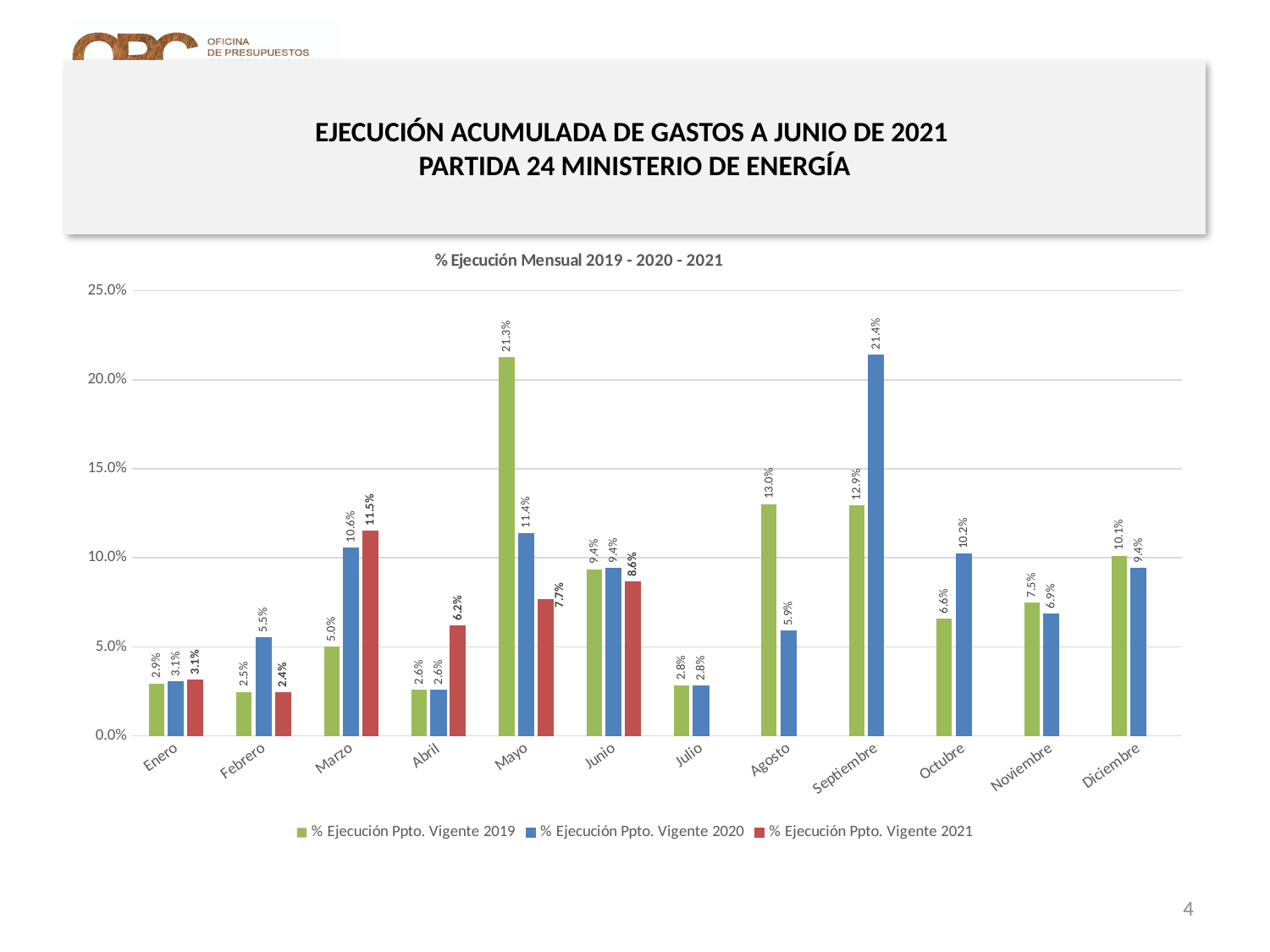
What is the value for % Ejecución Ppto. Vigente 2020 in Octubre? 10.2% Which month has the highest value for % Ejecución Ppto. Vigente 2020? Septiembre Which is larger in Abril: the 2021 value or the 2019 value? 2021 value What is the value for % Ejecución Ppto. Vigente 2019 in Mayo? 21.3% How many series does the legend list? 3 What is the title of the chart? % Ejecución Mensual 2019 - 2020 - 2021 What is the value for % Ejecución Ppto. Vigente 2021 in Marzo? 11.5% Which month has the lowest value for % Ejecución Ppto. Vigente 2021? Febrero Is the value for % Ejecución Ppto. Vigente 2019 in Mayo greater or less than 20.0%? greater What is the difference between the 2019 and 2020 values in Agosto? 7.1% How many months are shown on the x axis? 12 What kind of chart is shown on the slide? Bar chart